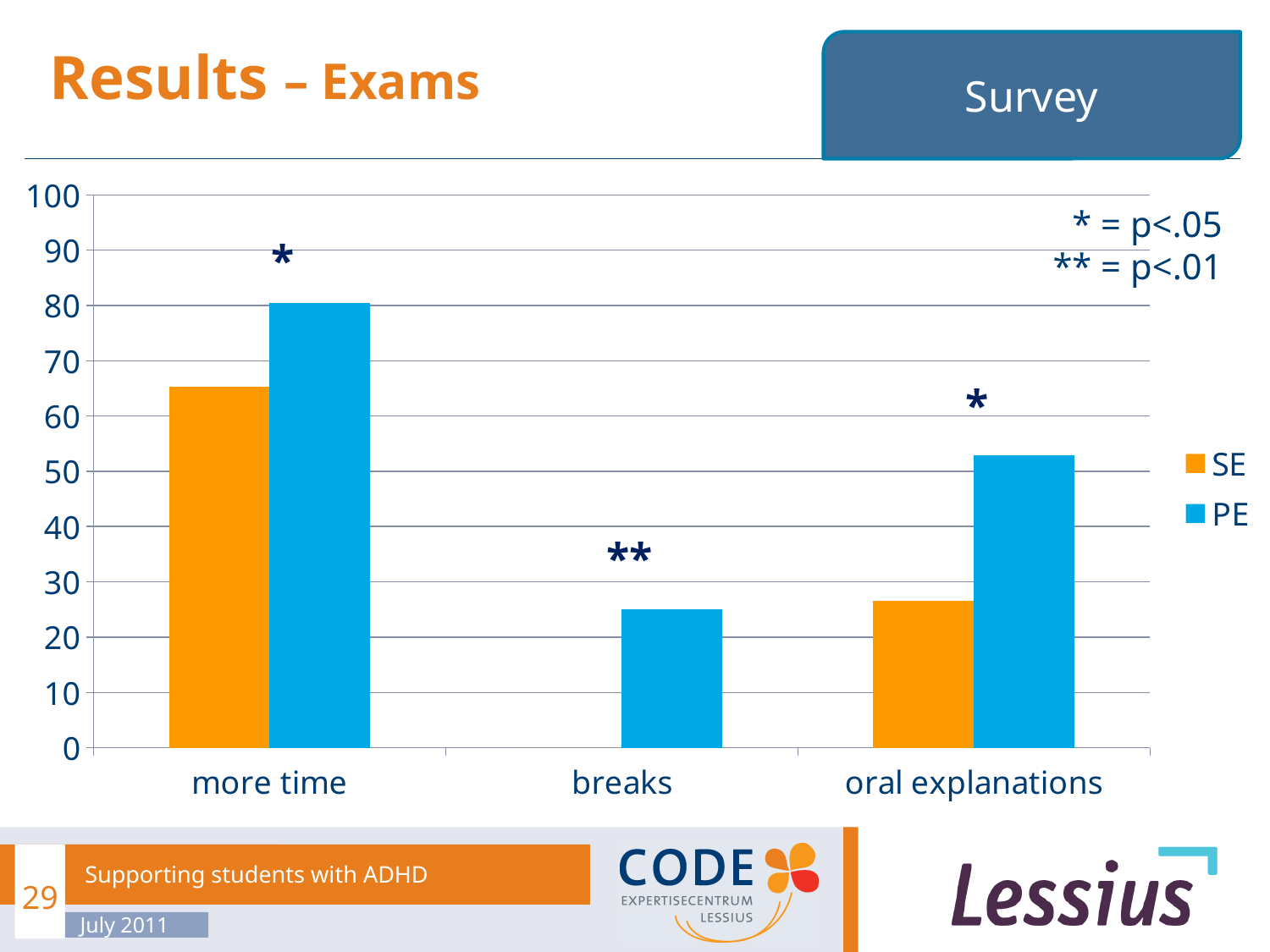
What colour are the SE bars in the chart? orange Which category has the highest PE value? more time Is the PE value for 'breaks' greater or less than 30? less Is the SE value for 'more time' greater or less than 60? greater Is the SE value for 'oral explanations' greater or less than 30? less What kind of chart is shown on the slide? bar chart For 'more time', which is larger, the SE value or the PE value? PE Which series are listed in the chart's legend? SE and PE How many series does the chart's legend list? 2 How many categories are shown on the x axis of the chart? 3